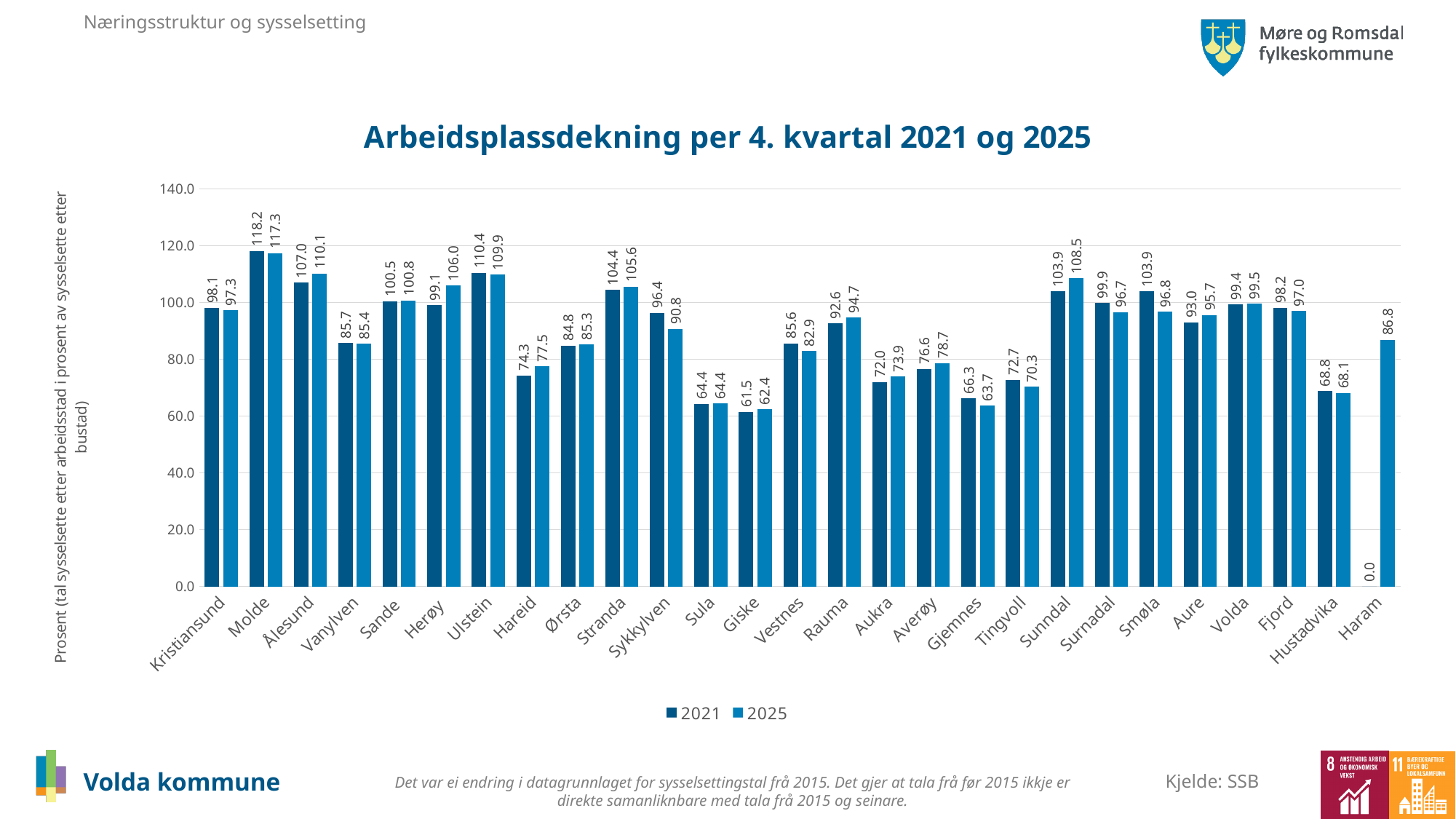
What is the difference between the 2025 and 2021 values for Herøy? 6.9 How many series does the legend list? 2 What is the value for Molde in the 2021 series? 118.2 Which municipality has the lowest value in the 2025 series? Giske What is the title of the chart? Arbeidsplassdekning per 4. kvartal 2021 og 2025 Which is larger for Sykkylven, the 2021 value or the 2025 value? 2021 How many municipalities are shown on the x axis? 27 What is the value for Haram in the 2025 series? 86.8 What kind of chart is shown on the slide? Bar chart Which municipality has the highest value in the 2025 series? Molde What is the value for Sunndal in the 2025 series? 108.5 Is the 2021 value for Ulstein greater or less than 100.0? greater